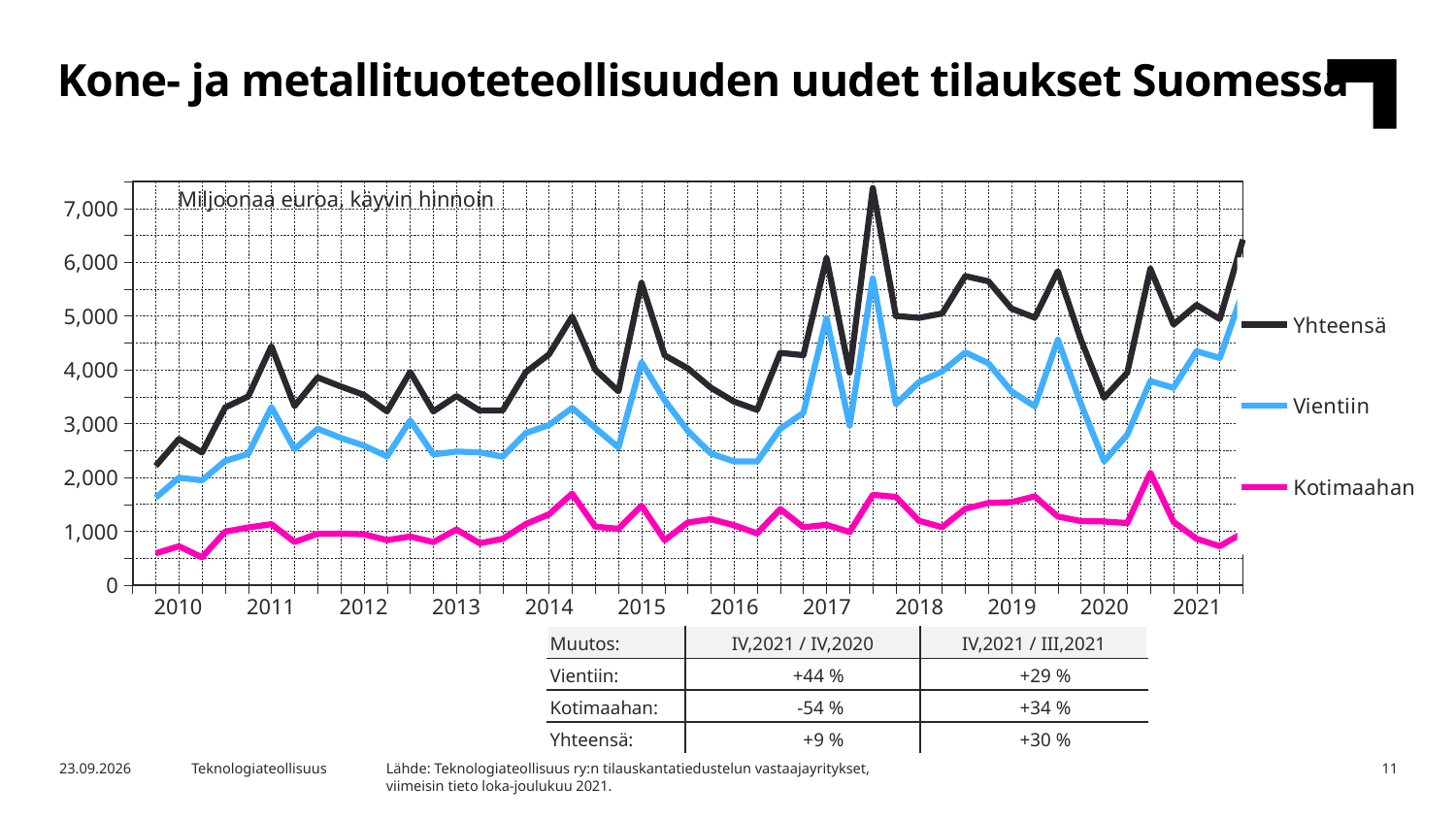
Is the value for Vientiin at the start of 2010 greater or less than 2,000? less How many series does the legend list? 3 Which is larger at the end of 2021, Vientiin or Kotimaahan? Vientiin Which series has the lowest values throughout the chart? Kotimaahan Is the last value for Yhteensä at the end of 2021 greater or less than 6,000? greater Does the Yhteensä series overall rise or fall from 2010 to 2021? rise What unit label is shown inside the chart area? Miljoonaa euroa, käyvin hinnoin Is the highest value of Kotimaahan greater or less than 3,000? less Which series has the highest values throughout the chart? Yhteensä What kind of chart is shown on the slide? Line chart How many year labels are shown on the x axis? 12